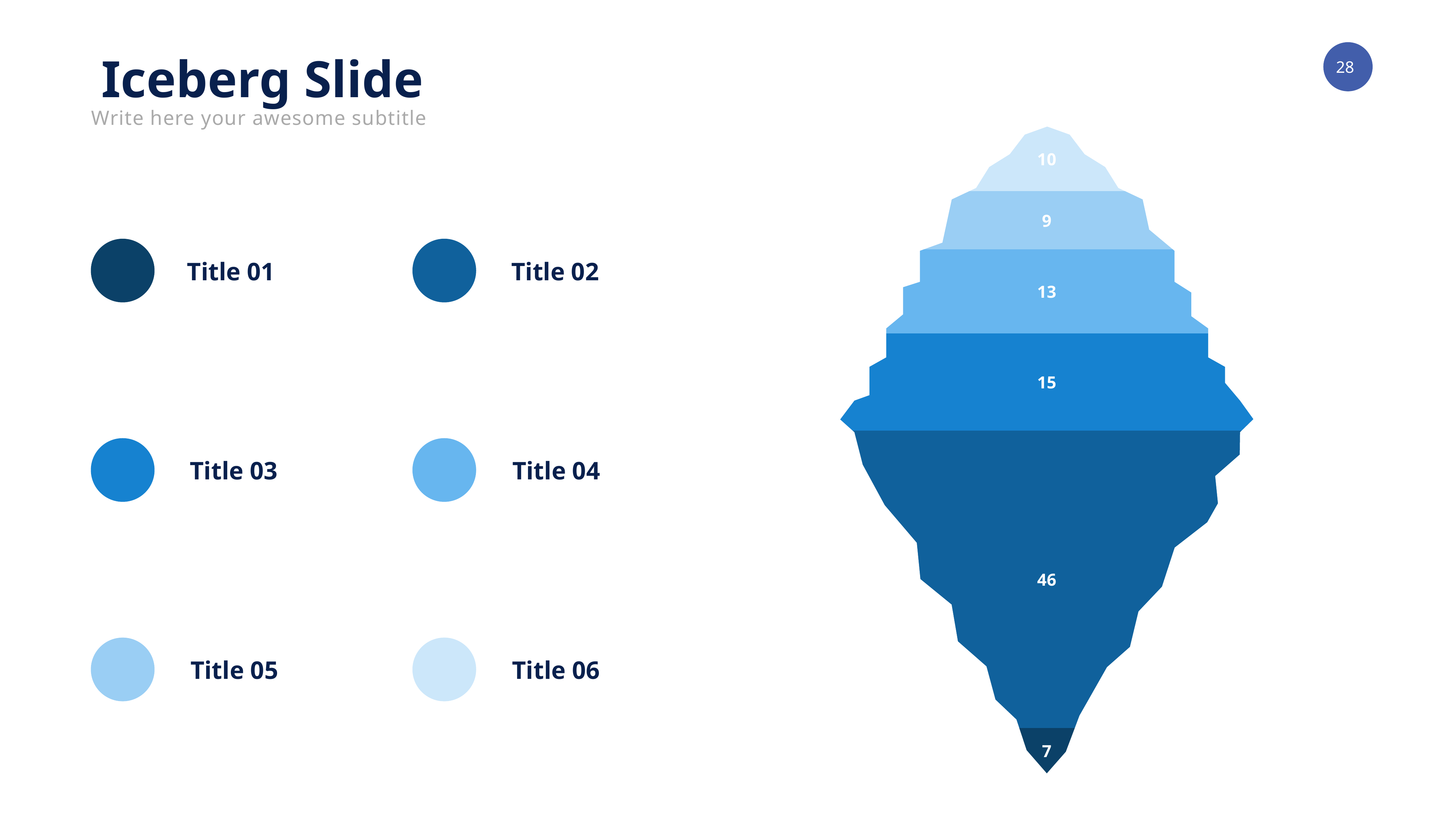
What is the difference between the largest segment value (46) and the segment value 15 in the iceberg? 31 What is the title of the slide? Iceberg Slide What value is printed in the topmost segment of the iceberg? 10 What value is shown in the segment of the iceberg that matches the colour of Title 02? 46 How many labelled segments does the iceberg have? 6 Which segment of the iceberg has the largest value? 46 What value is printed in the segment of the iceberg directly above the waterline? 15 How many titles are listed in the legend on the left of the slide? 6 What value is shown in the segment of the iceberg that matches the colour of Title 01? 7 Which segment of the iceberg has the smallest value? 7 Which is larger in the iceberg: the segment labelled 13 or the segment labelled 9? 13 What is the total of all the segment values in the iceberg? 100